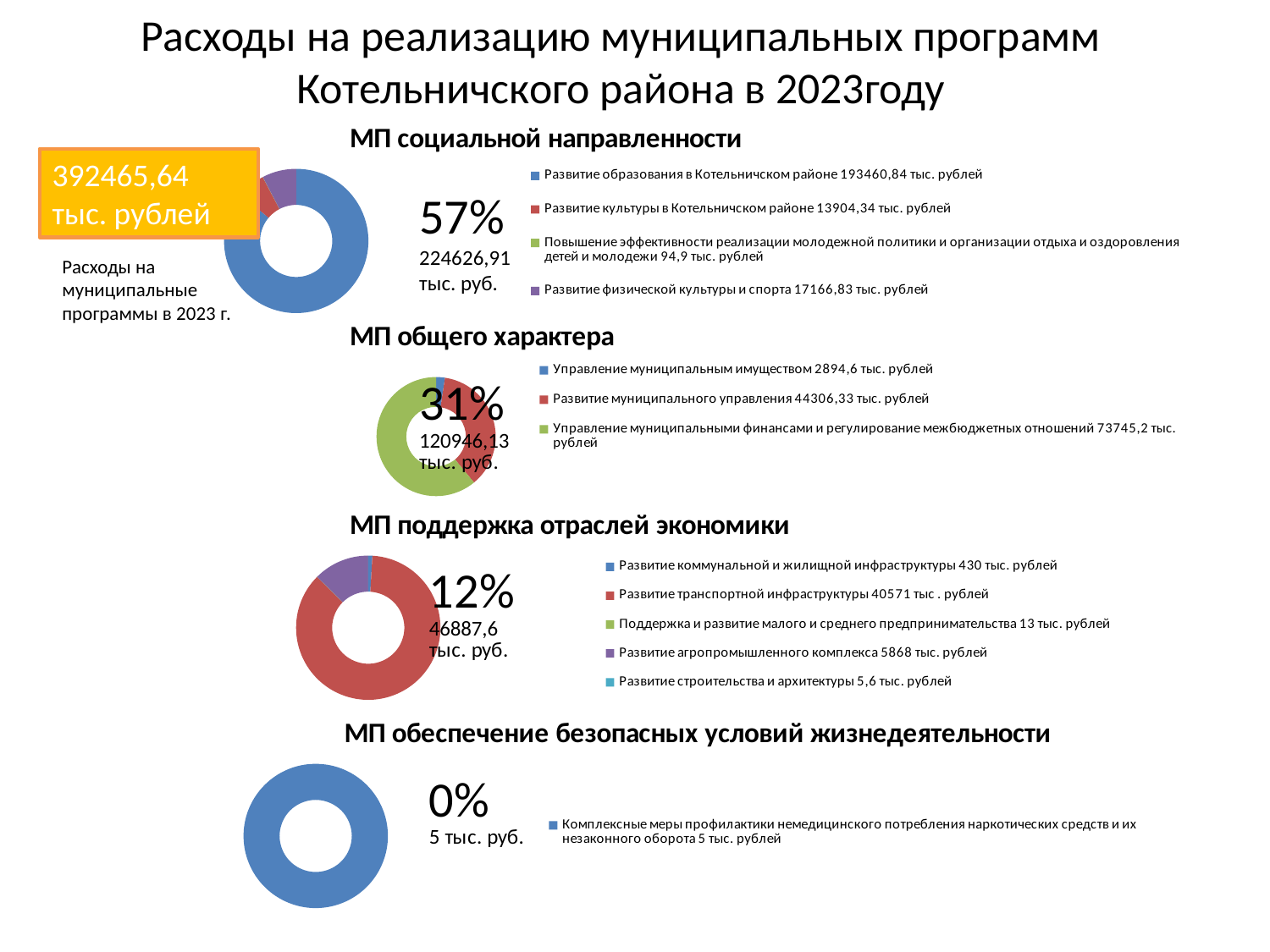
On the 'МП общего характера' chart, which legend entry has the largest value? Управление муниципальными финансами и регулирование межбюджетных отношений On the 'МП поддержка отраслей экономики' chart, how many legend entries are listed? 5 On the 'МП общего характера' chart, what is the value for 'Развитие муниципального управления'? 44306,33 тыс. рублей On the 'МП поддержка отраслей экономики' chart, which is larger: 'Развитие коммунальной и жилищной инфраструктуры' or 'Развитие агропромышленного комплекса'? Развитие агропромышленного комплекса What share of total expenditure does the 'МП социальной направленности' chart show? 57% On the 'МП социальной направленности' chart, how many legend entries are listed? 4 What total amount is shown in the orange box at the top left of the slide? 392465,64 тыс. рублей On the 'МП социальной направленности' chart, which legend entry has the smallest value? Повышение эффективности реализации молодежной политики и организации отдыха и оздоровления детей и молодежи On the 'МП поддержка отраслей экономики' chart, what is the value for 'Развитие транспортной инфраструктуры'? 40571 тыс. рублей What kind of chart is used for 'МП обеспечение безопасных условий жизнедеятельности'? Doughnut (pie) chart On the 'МП социальной направленности' chart, what is the value for 'Развитие образования в Котельничском районе'? 193460,84 тыс. рублей On the 'МП общего характера' chart, what is the difference between 'Управление муниципальными финансами и регулирование межбюджетных отношений' and 'Развитие муниципального управления'? 29438,87 тыс. рублей